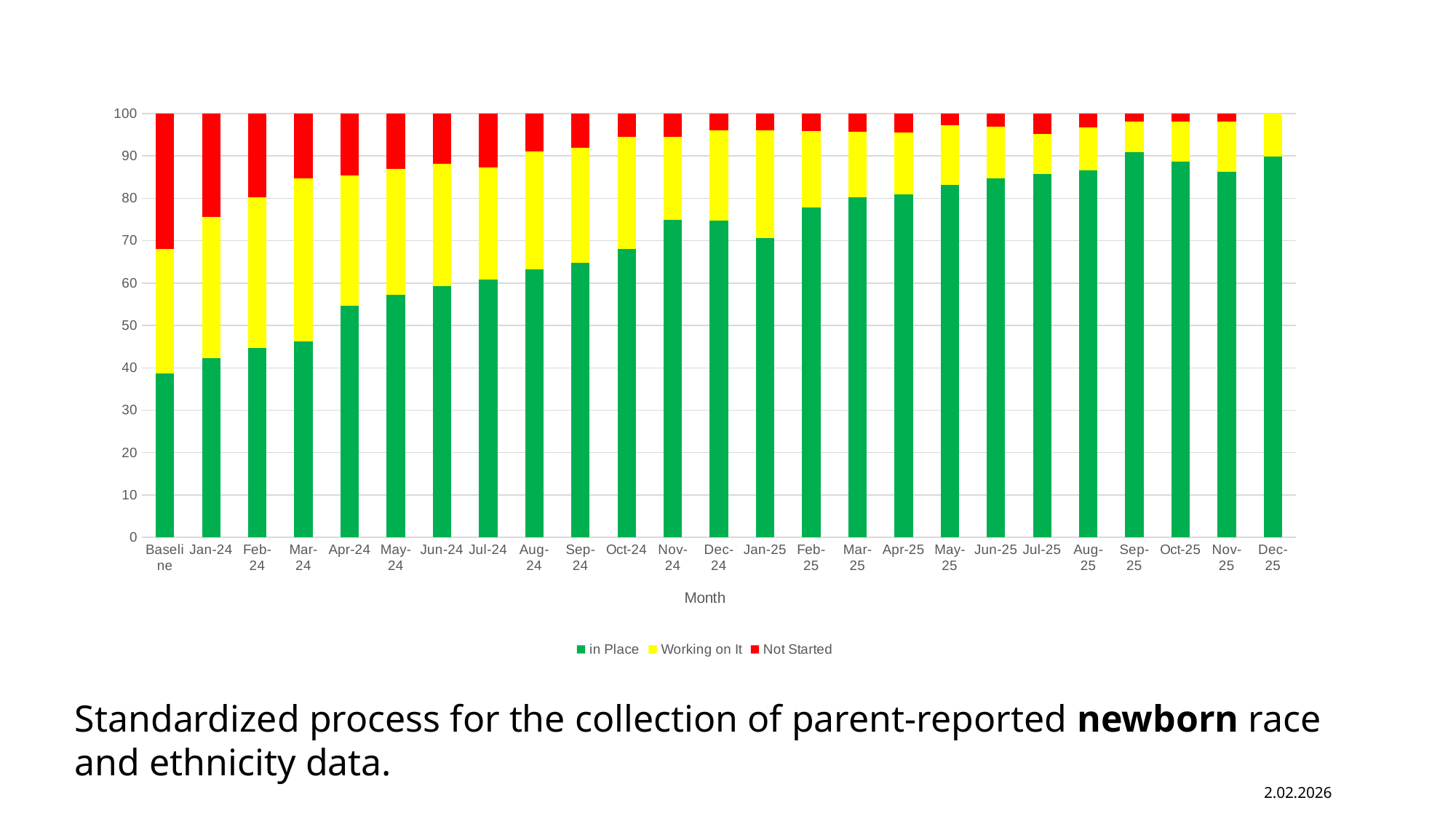
What is the total height of the stacked bar for Baseline? 100 Which category has the smallest 'in Place' value? Baseline Is the 'in Place' value for Nov-24 greater or less than 70? greater Which has the larger 'in Place' value, Dec-24 or Jan-25? Dec-24 What is the title of the x axis? Month Does the 'in Place' value generally rise or fall from Baseline to Dec-25? rise What kind of chart is shown on the slide? Stacked bar chart How many categories are shown on the x axis? 25 Is the 'in Place' value for Baseline greater or less than 40? less Which category has the largest 'Not Started' segment? Baseline How many series does the legend list? 3 Is the 'in Place' value for Mar-24 greater or less than 50? less